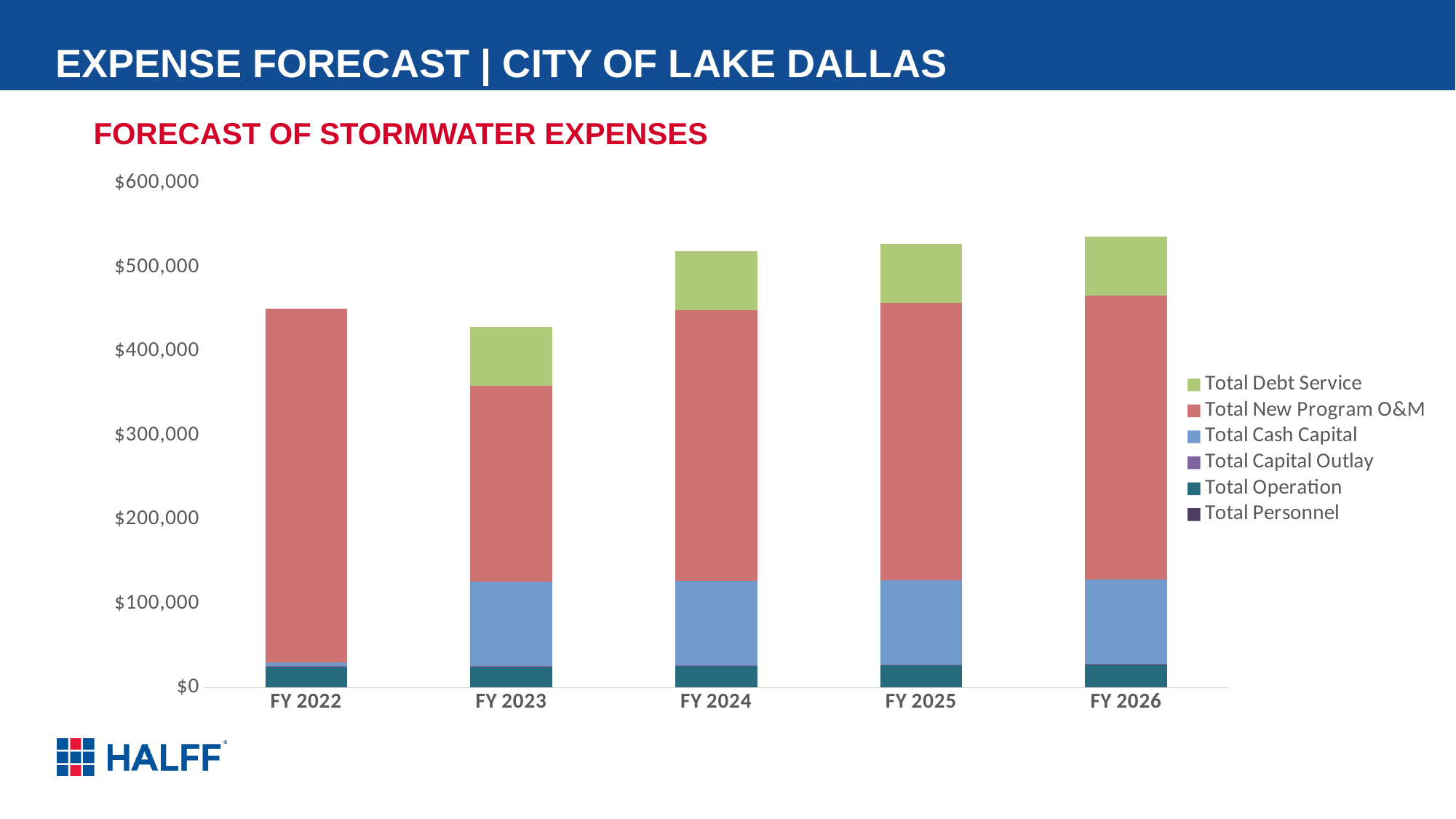
Which fiscal year's bar shows no Total Debt Service segment? FY 2022 What is the title of the chart? FORECAST OF STORMWATER EXPENSES How many series does the chart legend list? 6 Is the total bar for FY 2022 greater or less than $400,000? greater Which fiscal year has the lowest total stacked bar? FY 2023 What kind of chart is shown on the slide? Stacked bar chart Is the total bar for FY 2023 greater or less than $500,000? less Is the total bar for FY 2024 greater or less than $500,000? greater Which fiscal year has the highest total stacked bar? FY 2026 Do the total bars rise or fall from FY 2023 to FY 2026? rise Which has the larger total bar, FY 2022 or FY 2023? FY 2022 How many fiscal years are shown on the x axis of the chart? 5